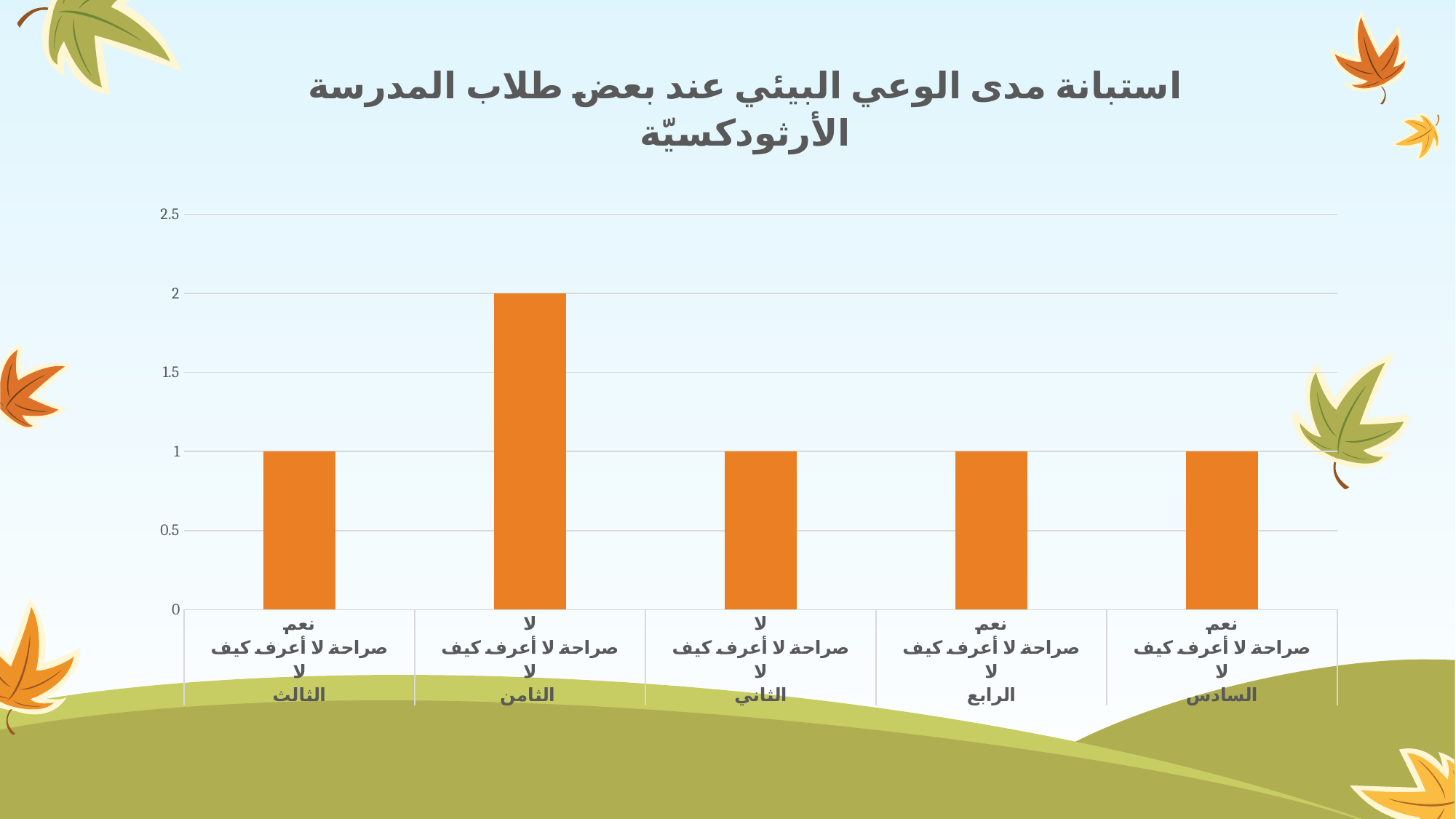
Is the value for الرابع greater or less than 1.5? less What is the difference between the values for الثامن and الرابع? 1 Which category has the highest bar? الثامن What is the value of the bar for الثالث? 1 What is the highest value shown on the vertical axis? 2.5 Is the value for الثامن greater or less than 1.5? greater Which is larger, the value for الثامن or the value for الثاني? الثامن How many bars are plotted in the chart? 5 What kind of chart is shown on the slide? bar chart What is the value of the bar for السادس? 1 What is the value of the bar for الثامن? 2 What colour are the bars in the chart? orange